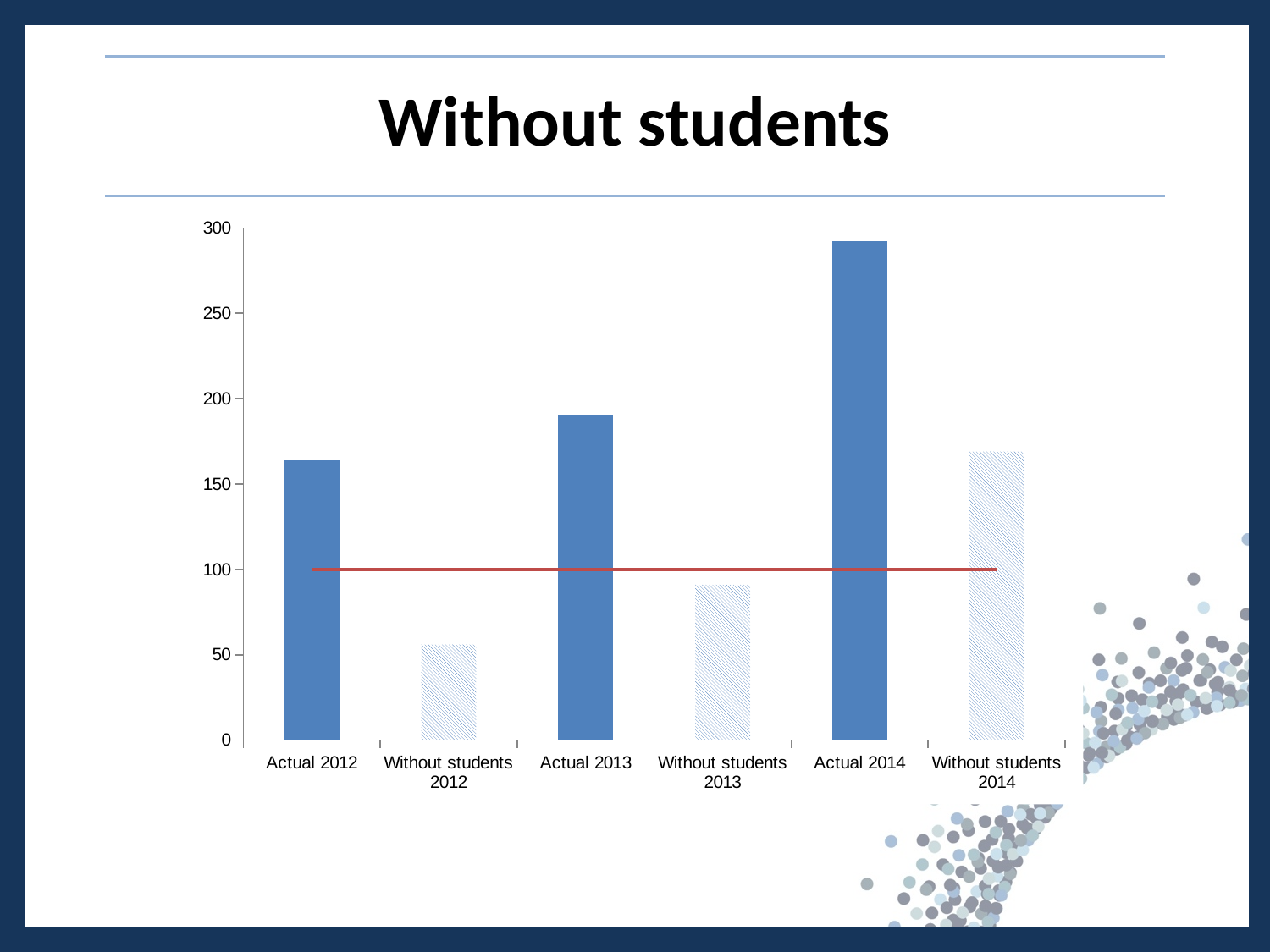
At what value on the vertical axis is the red horizontal line drawn? 100 Is the value for Without students 2013 greater or less than 100? less Which category has the lowest bar? Without students 2012 Which category has the highest bar? Actual 2014 Is the value for Actual 2012 greater or less than 150? greater How many bars are plotted in the chart? 6 Which is larger, the value for Actual 2013 or the value for Without students 2014? Actual 2013 Is the value for Without students 2014 greater or less than 150? greater What kind of chart is shown on the slide? bar chart